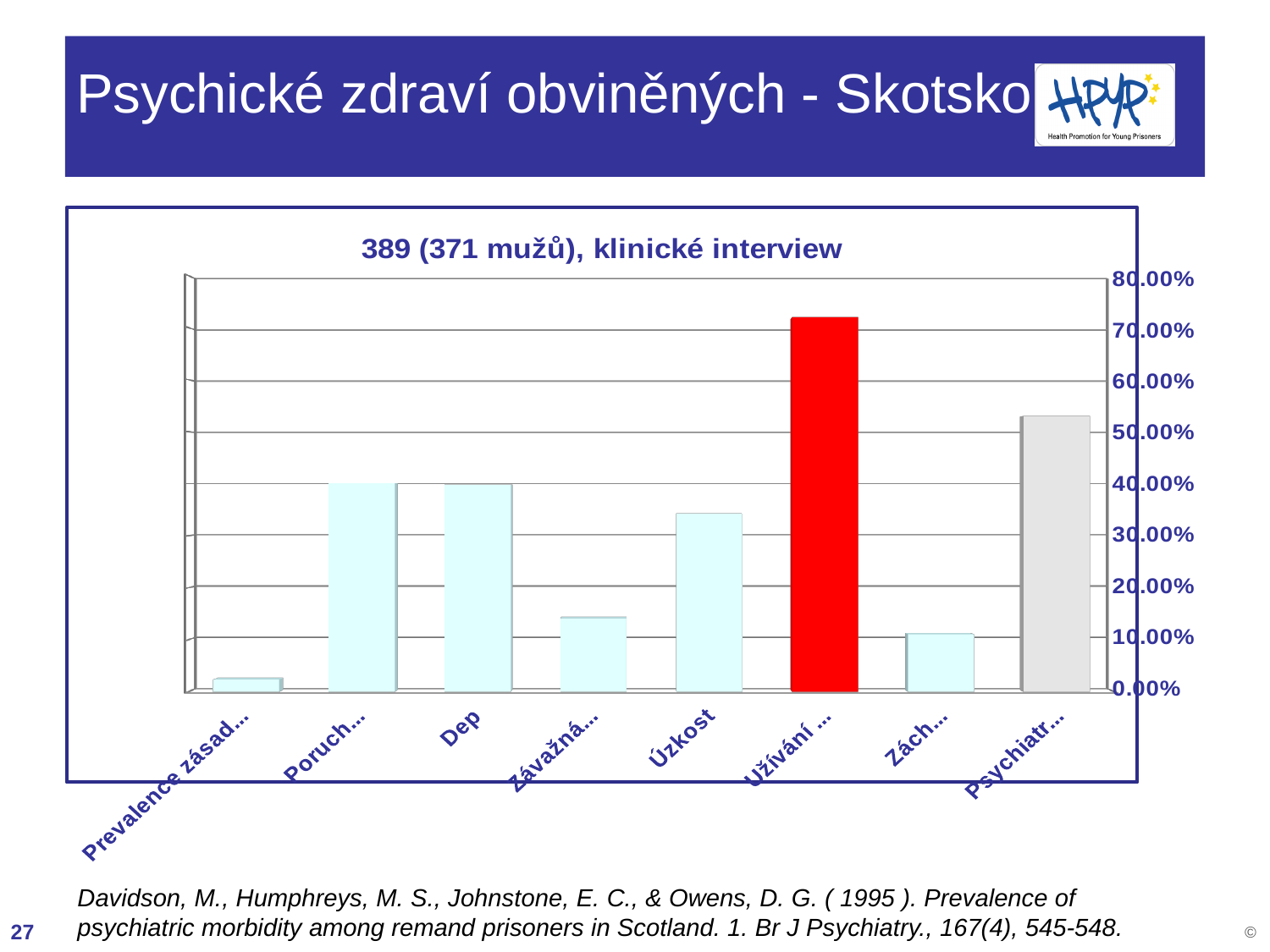
Is the value of the red bar (Užívání ...) greater or less than 60.00%? greater Is the value of the seventh bar from the left (Zách...) greater or less than 20.00%? less What is the title of the chart? 389 (371 mužů), klinické interview What kind of chart is shown on the slide? bar chart Is the value for Dep greater or less than 50.00%? less Which is larger, the value for Dep or the value for Úzkost? Dep Which category has the tallest bar? Užívání ... What colour is the tallest bar in the chart? red Which category has the shortest bar? Prevalence zásad... How many bars (categories) does the chart show? 8